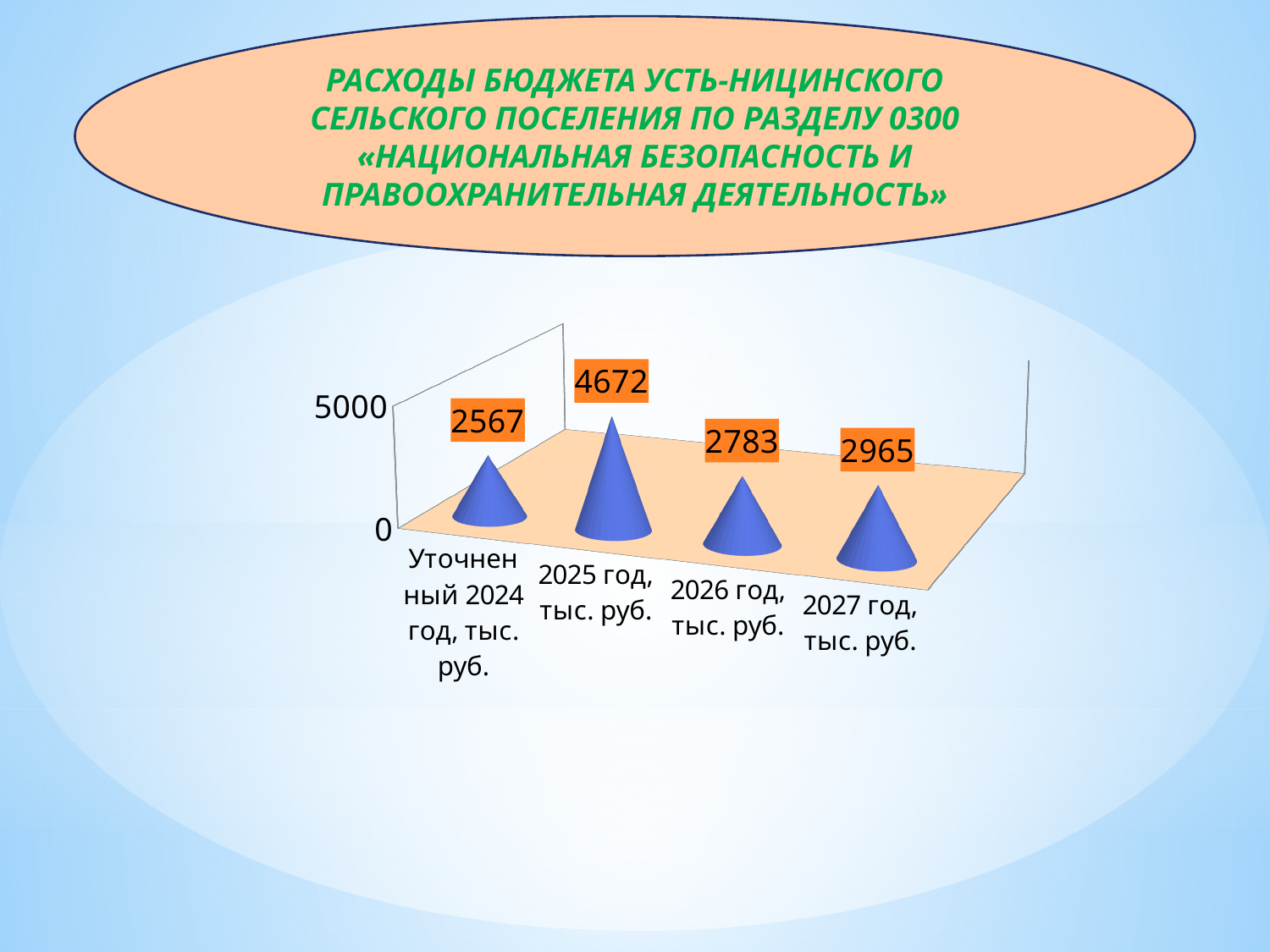
What is the value for Уточненный 2024 год, тыс. руб.? 2567 What is the difference between the values for 2025 год and 2026 год? 1889 Which is larger, the value for 2026 год or the value for 2027 год? 2027 год, тыс. руб. What is the value for 2026 год, тыс. руб.? 2783 What is the difference between the values for 2027 год and Уточненный 2024 год? 398 What is the value for 2027 год, тыс. руб.? 2965 Which category has the lowest value? Уточненный 2024 год, тыс. руб. Which category has the highest value? 2025 год, тыс. руб. How many categories are shown on the chart? 4 Is the value for 2025 год greater or less than 5000? less What kind of chart is shown on the slide? bar chart What is the value for 2025 год, тыс. руб.? 4672